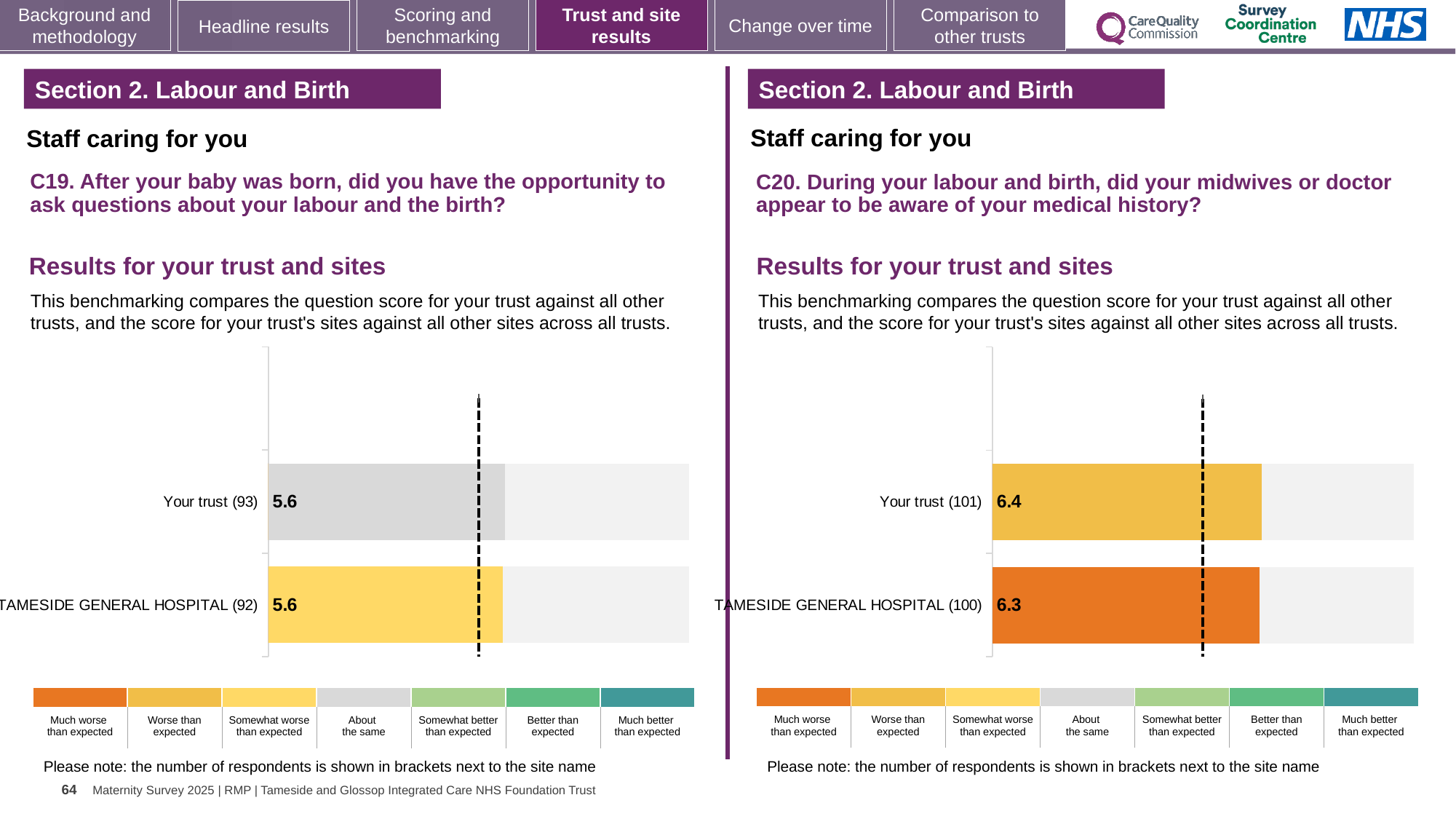
In the C20 chart on the right, what is the score for TAMESIDE GENERAL HOSPITAL? 6.3 In the C20 chart on the right, which has the higher score, Your trust or TAMESIDE GENERAL HOSPITAL? Your trust In the C20 chart on the right, what is the score for Your trust? 6.4 How many categories does the colour key below the C19 chart on the left list? 7 In the C19 chart on the left, how many bars are plotted? 2 In the C19 chart on the left, is the score for Your trust the same as the score for TAMESIDE GENERAL HOSPITAL? Yes In the C19 chart on the left, how many respondents are shown in brackets for Your trust? 93 In the C19 chart on the left, what is the score for TAMESIDE GENERAL HOSPITAL? 5.6 In the C19 chart on the left, what is the score for Your trust? 5.6 In the C20 chart on the right, what is the difference between the score for Your trust and the score for TAMESIDE GENERAL HOSPITAL? 0.1 What type of chart is used in the C20 chart on the right? Bar chart In the C20 chart on the right, how many respondents are shown in brackets for TAMESIDE GENERAL HOSPITAL? 100